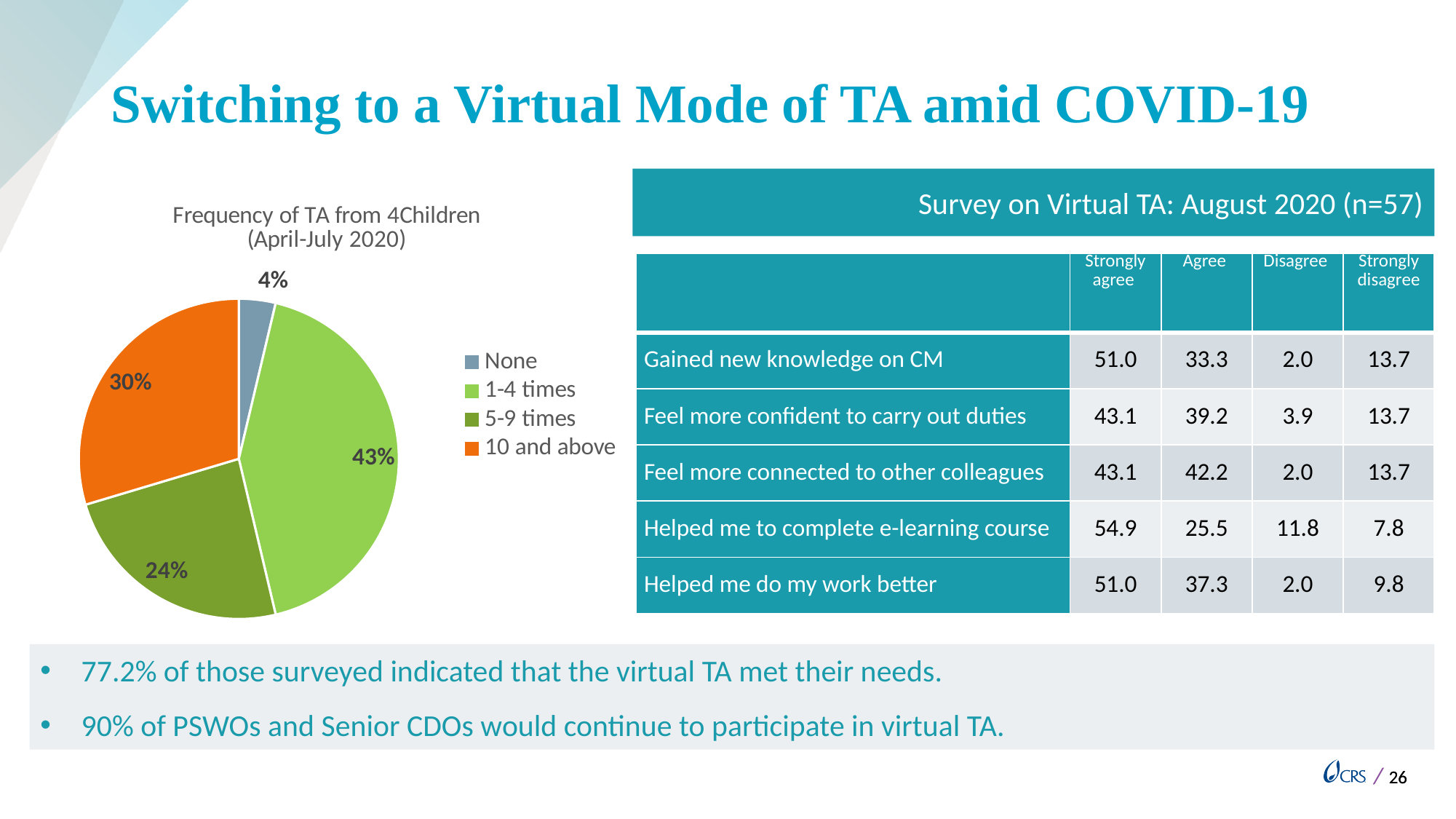
What kind of chart is shown on the slide? Pie chart Which category has the largest slice in the pie chart? 1-4 times What is the title of the pie chart? Frequency of TA from 4Children (April-July 2020) What is the difference in percentage points between the "1-4 times" slice and the "10 and above" slice in the pie chart? 13% What colour is the "10 and above" slice in the pie chart? Orange What share of the pie chart is labelled "1-4 times"? 43% In the pie chart, which is larger: the share for "10 and above" or the share for "5-9 times"? 10 and above How many categories does the pie chart legend list? 4 What share of the pie chart is labelled "None"? 4% What share of the pie chart is labelled "10 and above"? 30% Which category has the smallest slice in the pie chart? None